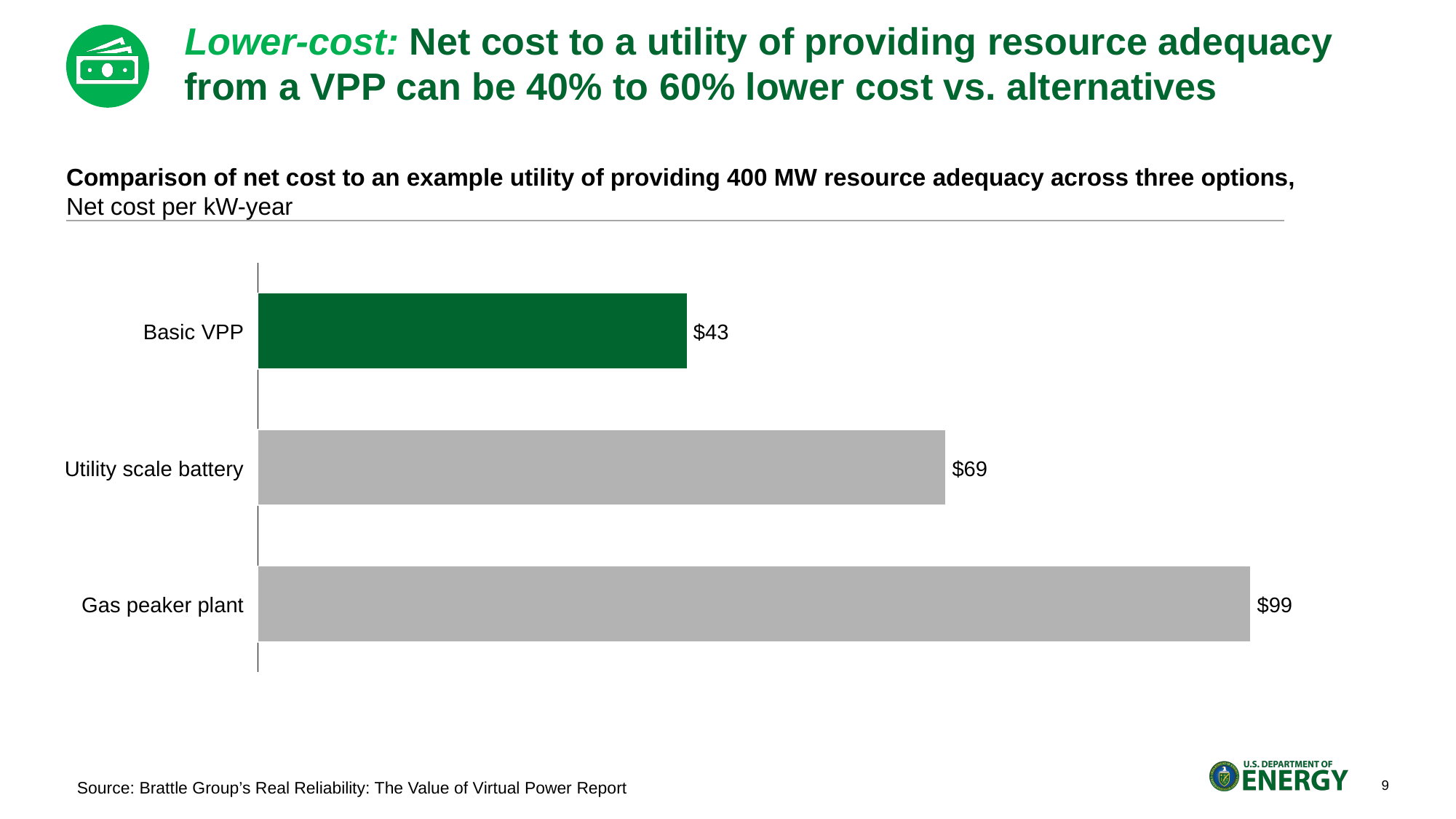
What kind of chart is shown on the slide? Bar chart What is the difference in net cost per kW-year between Utility scale battery and Basic VPP? $26 How many options are compared in the chart? 3 Which option has the highest net cost per kW-year? Gas peaker plant What is the net cost per kW-year for Basic VPP? $43 Which option has the lowest net cost per kW-year? Basic VPP What is the net cost per kW-year for Gas peaker plant? $99 Which bar in the chart is coloured green rather than grey? Basic VPP What unit is the net cost in the chart expressed in? Net cost per kW-year What is the net cost per kW-year for Utility scale battery? $69 Which has a higher net cost per kW-year, Utility scale battery or Gas peaker plant? Gas peaker plant What is the difference in net cost per kW-year between Gas peaker plant and Basic VPP? $56